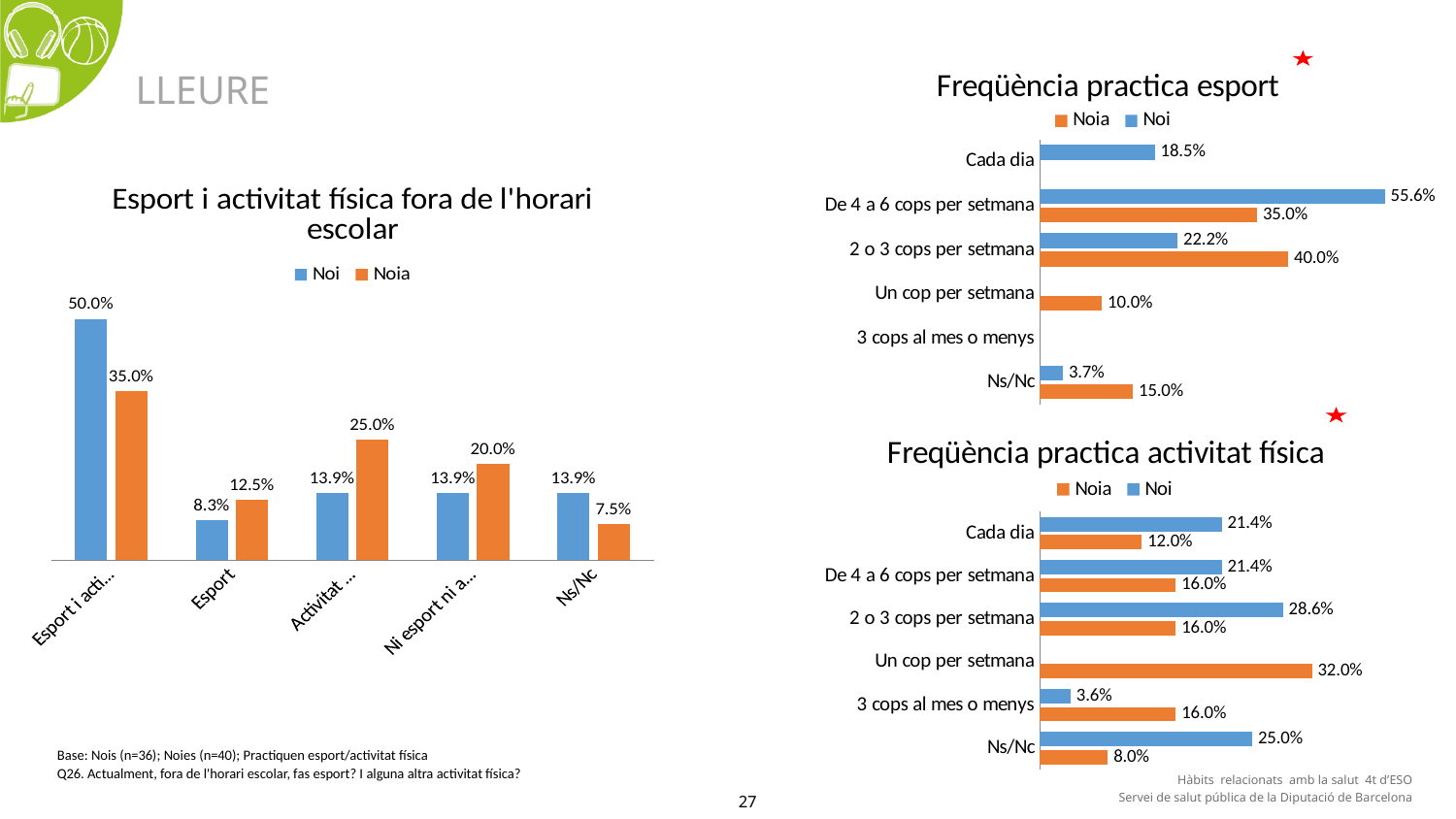
In the chart 'Freqüència practica activitat física', which category has the lowest value for Noi? Un cop per setmana In the chart 'Freqüència practica esport', what is the difference between Noi and Noia in 'De 4 a 6 cops per setmana'? 20.6% How many series does the legend of the chart 'Freqüència practica activitat física' list? 2 In the chart 'Freqüència practica esport', which is larger in 'Ns/Nc', Noi or Noia? Noia In the chart 'Esport i activitat física fora de l'horari escolar', what is the value for Noi in the 'Esport' category? 8.3% What kind of chart is 'Esport i activitat física fora de l'horari escolar'? Bar chart In the chart 'Freqüència practica esport', what is the value for Noi in 'De 4 a 6 cops per setmana'? 55.6% In the chart 'Freqüència practica activitat física', what is the value for Noia in 'Un cop per setmana'? 32.0% In the chart 'Esport i activitat física fora de l'horari escolar', what is the difference between Noia and Noi in the 'Esport' category? 4.2% In the chart 'Esport i activitat física fora de l'horari escolar', what is the value for Noia in the 'Ns/Nc' category? 7.5% In the chart 'Freqüència practica esport', which category has the highest value for Noia? 2 o 3 cops per setmana In the chart 'Esport i activitat física fora de l'horari escolar', how many categories are shown on the x axis? 5